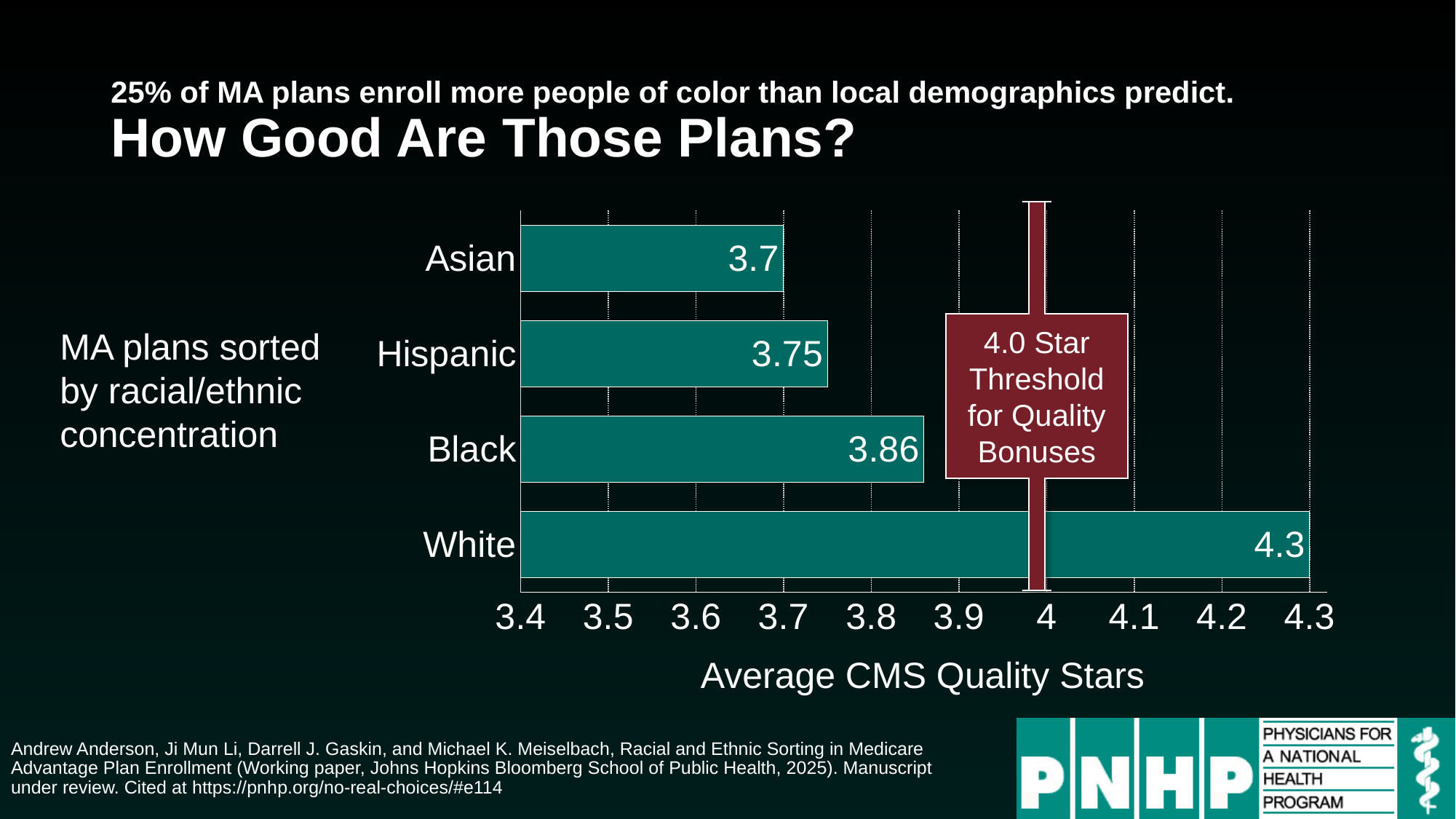
What is the average CMS quality star rating for Black-concentrated MA plans? 3.86 Which has a higher average CMS quality star rating, Black or Hispanic plans? Black Is the value for Black plans greater or less than 4? less What is the average CMS quality star rating for Asian-concentrated MA plans? 3.7 What type of chart is shown on the slide? Bar chart How many racial/ethnic categories are shown in the chart? 4 Which racial/ethnic group has the lowest average CMS quality stars? Asian What is the difference in average CMS quality stars between White and Black plans? 0.44 What is the average CMS quality star rating for Hispanic-concentrated MA plans? 3.75 What is the average CMS quality star rating for White-concentrated MA plans? 4.3 Which racial/ethnic group has the highest average CMS quality stars? White What is the difference in average CMS quality stars between Hispanic and Asian plans? 0.05